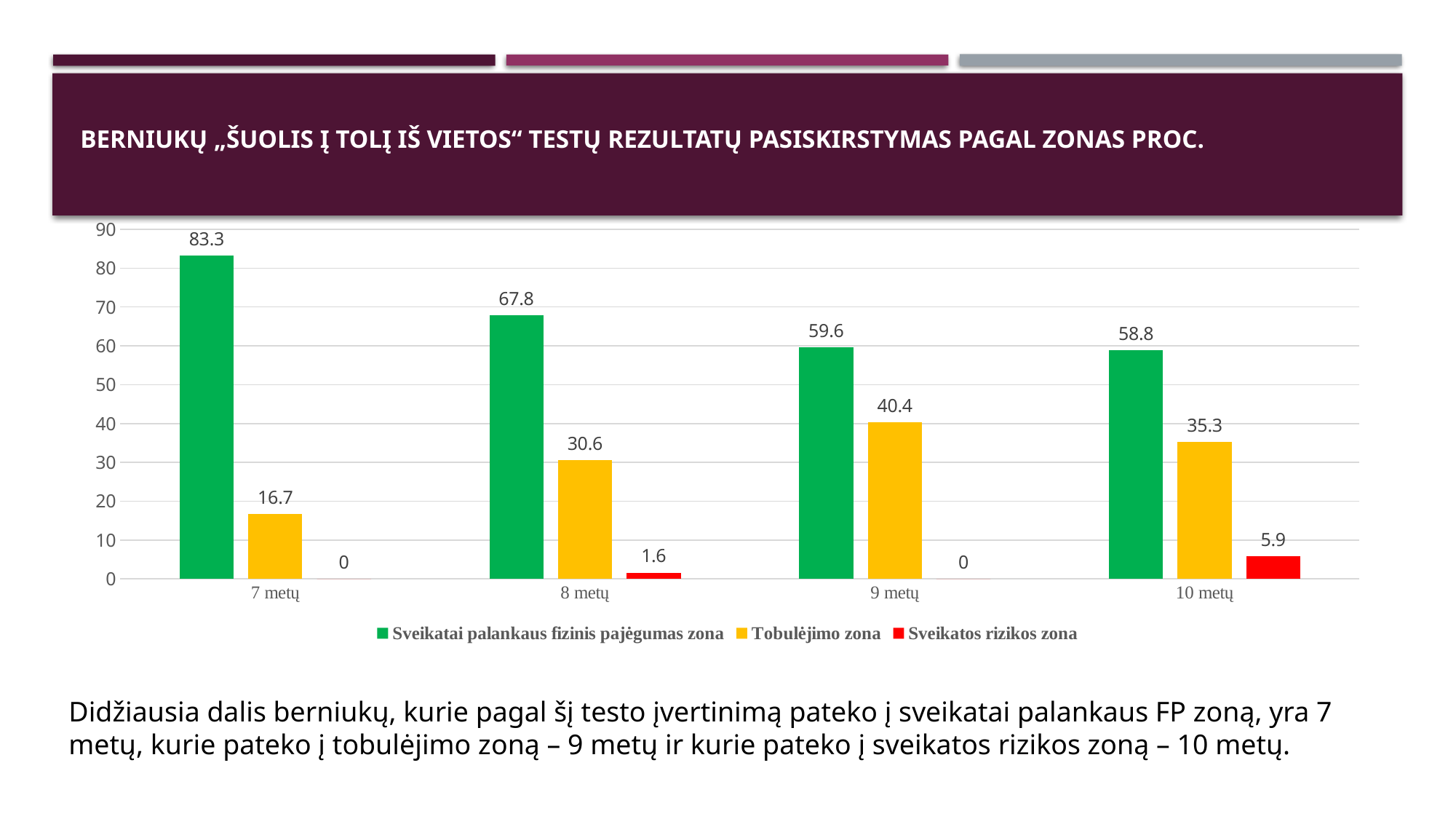
What kind of chart is shown on the slide? bar chart Which age group has the lowest value for the Tobulėjimo zona series? 7 metų Which age group has the highest value for the Sveikatai palankaus fizinis pajėgumas zona series? 7 metų How many series does the legend list? 3 Is the Sveikatai palankaus fizinis pajėgumas zona value for 9 metų greater or less than 50? greater Do the Sveikatai palankaus fizinis pajėgumas zona values rise or fall from 7 metų to 10 metų? fall What is the value of the Sveikatai palankaus fizinis pajėgumas zona series for 7 metų? 83.3 How many age groups are shown on the x axis? 4 What is the value of the Tobulėjimo zona series for 9 metų? 40.4 What is the difference between the Sveikatai palankaus fizinis pajėgumas zona values for 7 metų and 8 metų? 15.5 Which is larger: the Tobulėjimo zona value for 8 metų or for 10 metų? 10 metų What is the value of the Sveikatos rizikos zona series for 10 metų? 5.9